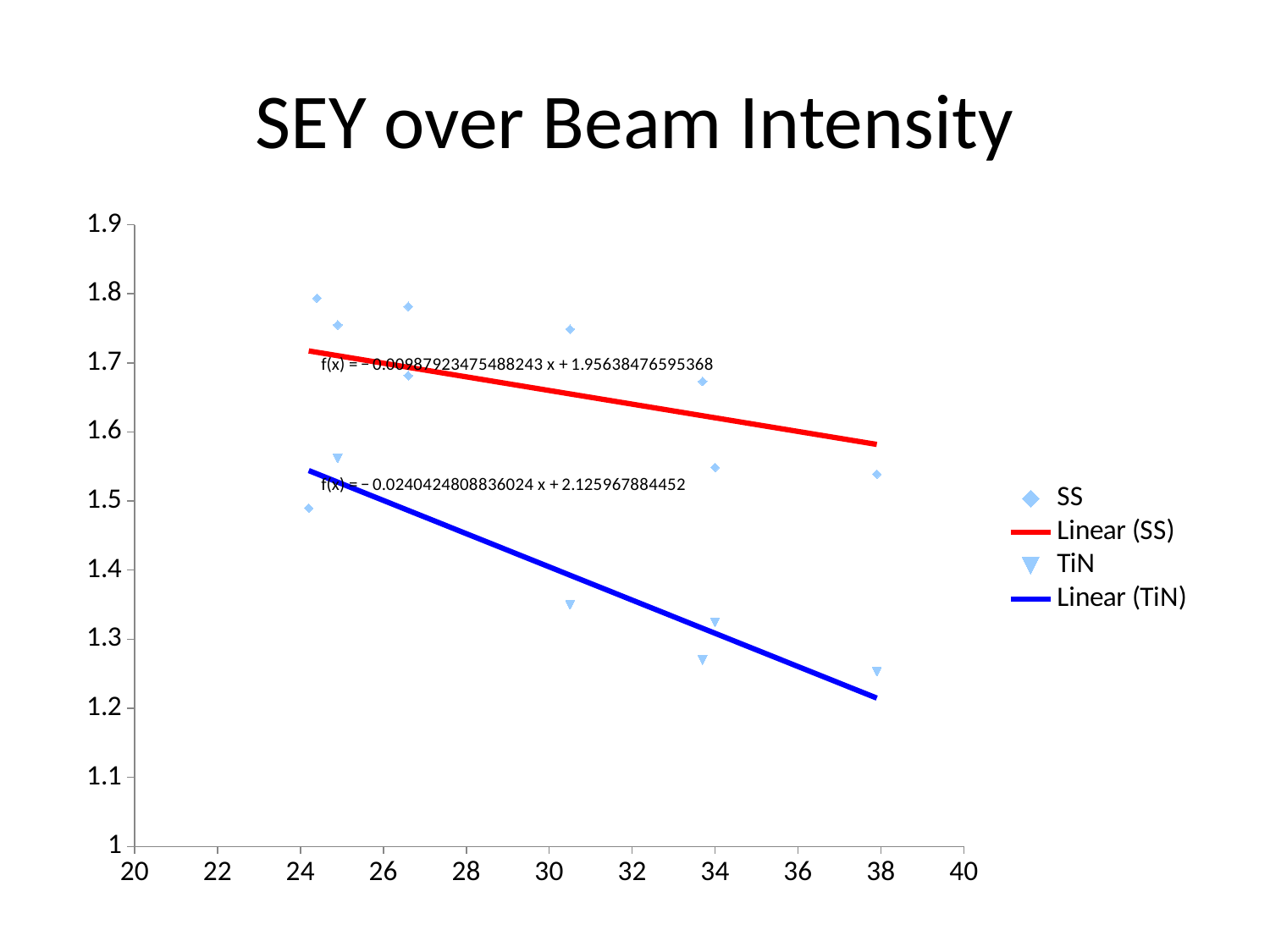
How many TiN data points are plotted? 5 What is the intercept printed in the trendline equation for the SS series? 1.95638476595368 What is the title of the chart? SEY over Beam Intensity Is the SS value at about x = 38 greater or less than 1.5? greater Does the Linear (TiN) trendline rise or fall as beam intensity increases along the x axis? fall Is the TiN value at about x = 30.5 greater or less than 1.4? less What is the slope printed in the trendline equation for the TiN series? -0.0240424808836024 Which trendline lies higher on the chart, Linear (SS) or Linear (TiN)? Linear (SS) What kind of chart is shown on the slide? scatter chart Does the Linear (SS) trendline rise or fall as x increases? fall What colour is the Linear (TiN) trendline? blue How many entries does the legend list? 4